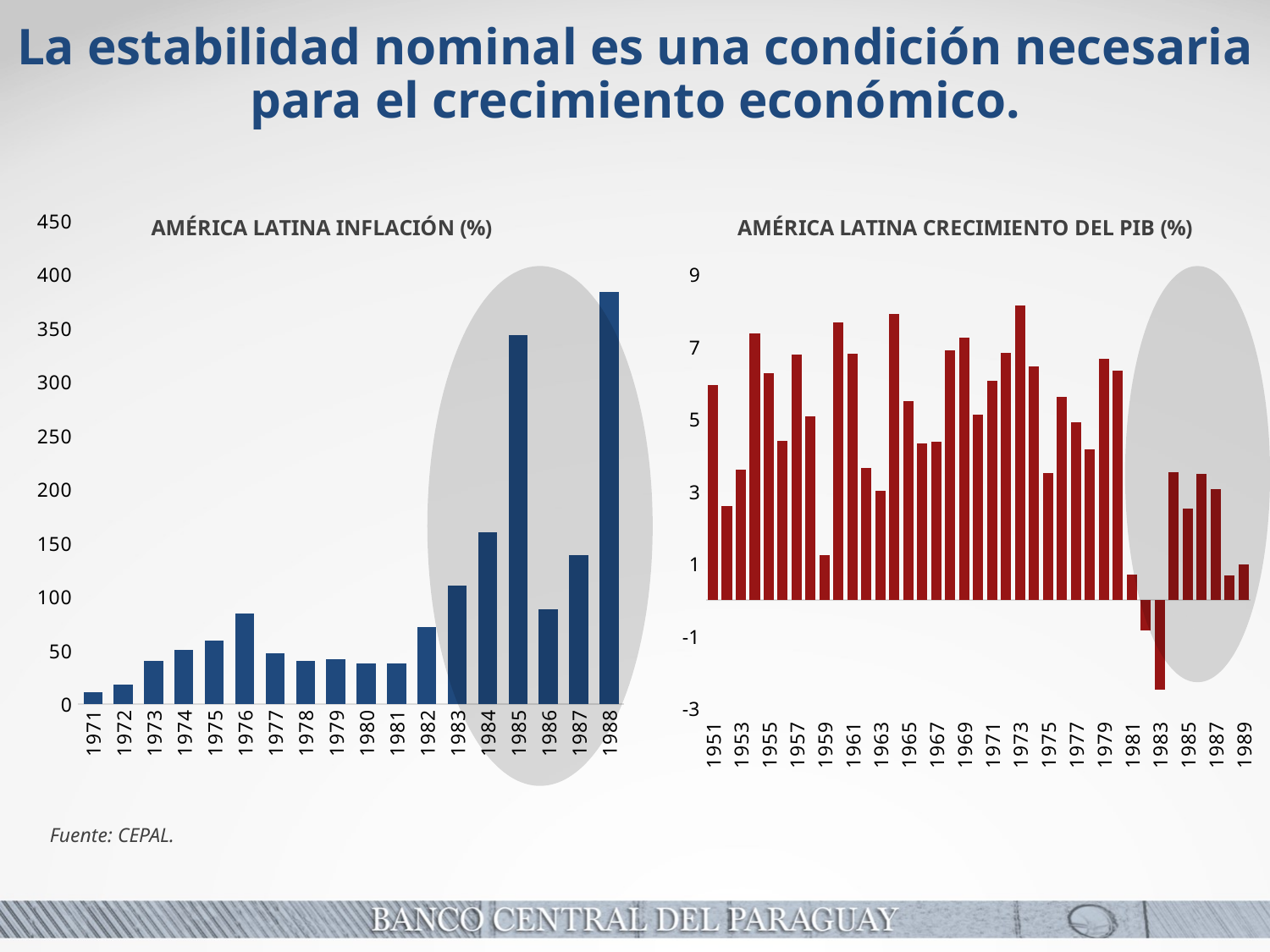
In the AMÉRICA LATINA CRECIMIENTO DEL PIB (%) chart, which year has the lowest GDP growth? 1983 In the AMÉRICA LATINA INFLACIÓN (%) chart, which year has the lowest inflation? 1971 In the AMÉRICA LATINA CRECIMIENTO DEL PIB (%) chart, which is larger, the value for 1951 or the value for 1952? 1951 How many years are plotted in the AMÉRICA LATINA INFLACIÓN (%) chart? 18 What colour are the bars in the AMÉRICA LATINA CRECIMIENTO DEL PIB (%) chart? red In the AMÉRICA LATINA INFLACIÓN (%) chart, is the value for 1982 greater or less than 100? less In the AMÉRICA LATINA CRECIMIENTO DEL PIB (%) chart, how many years show negative growth? 2 In the AMÉRICA LATINA INFLACIÓN (%) chart, which is larger, the value for 1985 or the value for 1986? 1985 What kind of chart is the AMÉRICA LATINA INFLACIÓN (%) chart? bar chart In the AMÉRICA LATINA INFLACIÓN (%) chart, which year has the highest inflation? 1988 In the AMÉRICA LATINA INFLACIÓN (%) chart, is the value for 1985 greater or less than 300? greater In the AMÉRICA LATINA CRECIMIENTO DEL PIB (%) chart, is the value for 1959 greater or less than 3? less